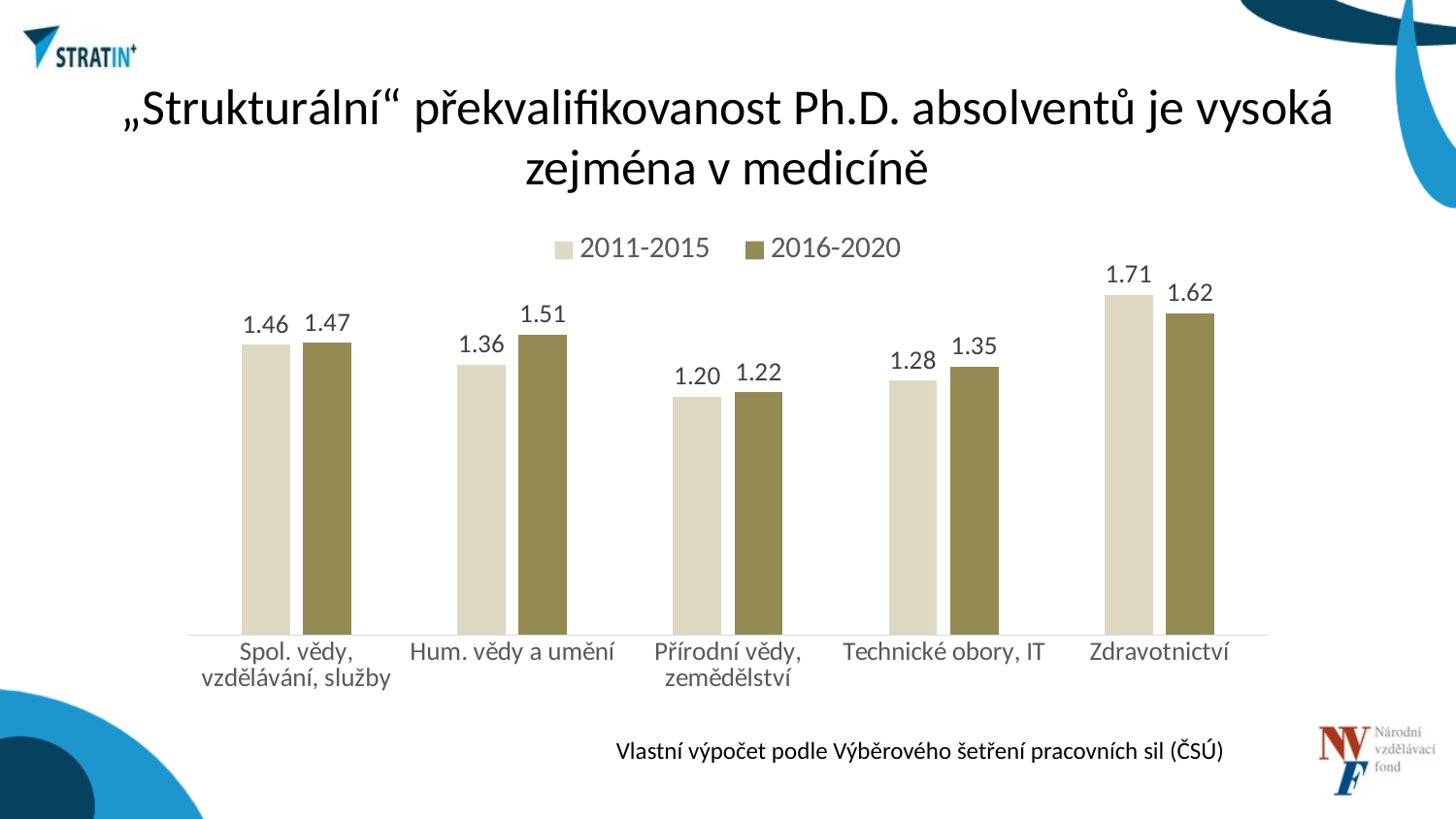
What is the difference between the 2016-2020 values for Hum. vědy a umění and Technické obory, IT? 0.16 What kind of chart is shown on the slide? Bar chart What is the value for Hum. vědy a umění in the 2016-2020 series? 1.51 What is the value for Přírodní vědy, zemědělství in the 2011-2015 series? 1.20 Which series is shown in the darker olive colour? 2016-2020 What is the value for Zdravotnictví in the 2011-2015 series? 1.71 How many series does the legend list? 2 How many categories are shown on the x axis? 5 Which is larger for Technické obory, IT: the 2011-2015 value or the 2016-2020 value? 2016-2020 Which category has the highest value in the 2016-2020 series? Zdravotnictví What is the difference between the 2011-2015 and 2016-2020 values for Zdravotnictví? 0.09 Which category has the lowest value in the 2011-2015 series? Přírodní vědy, zemědělství